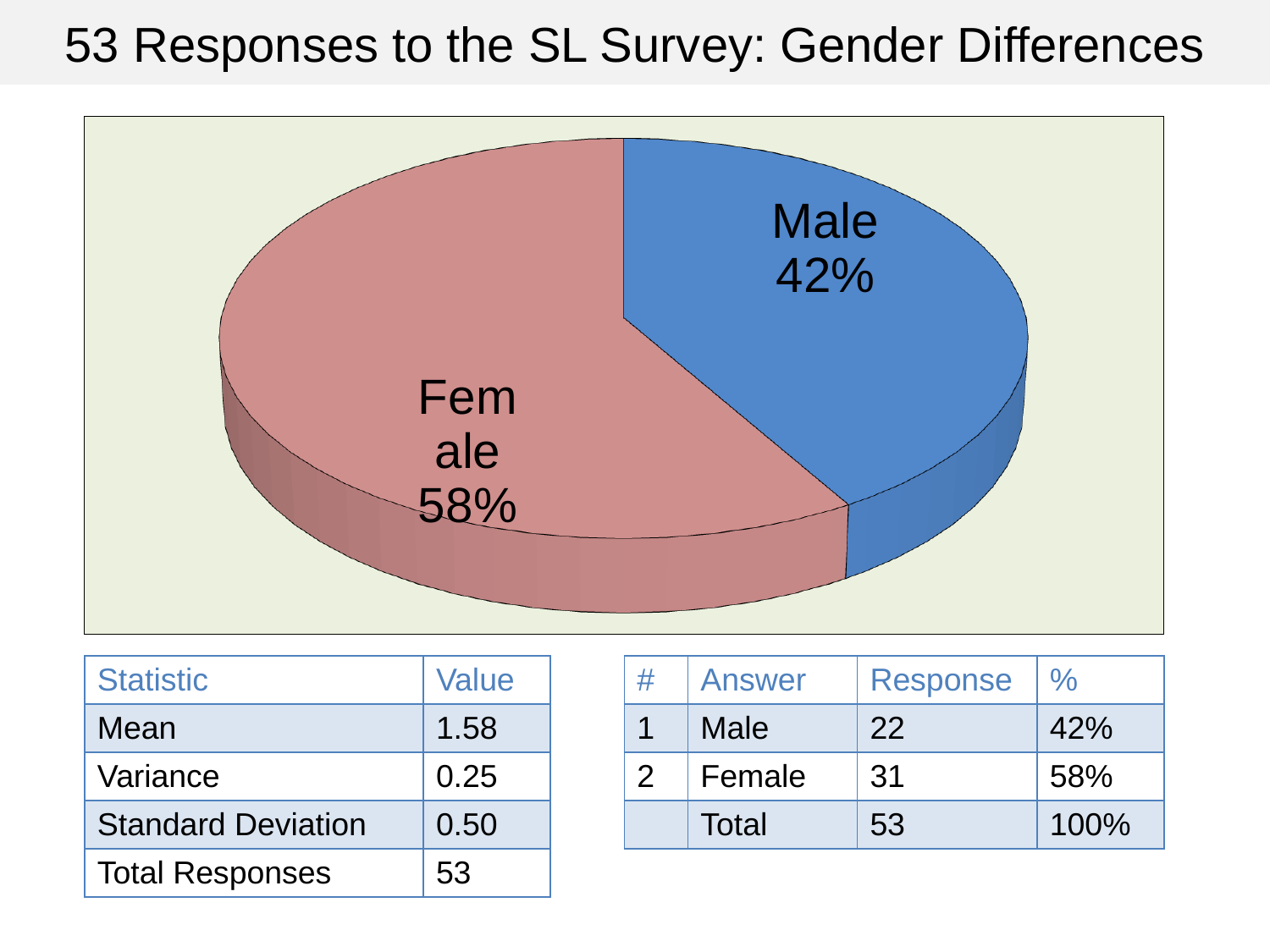
Is the share for Male greater or less than 50%? less What share of the pie does the Female slice represent? 58% What colour is the Female slice of the pie? pink What is the difference in percentage points between the Female and Male slices? 16% Which slice of the pie is the smallest? Male What kind of chart is shown on the slide? pie chart What colour is the Male slice of the pie? blue Which is larger, the Male slice or the Female slice? Female What share of the pie does the Male slice represent? 42% How many slices does the pie chart have? 2 Which slice of the pie is the largest? Female